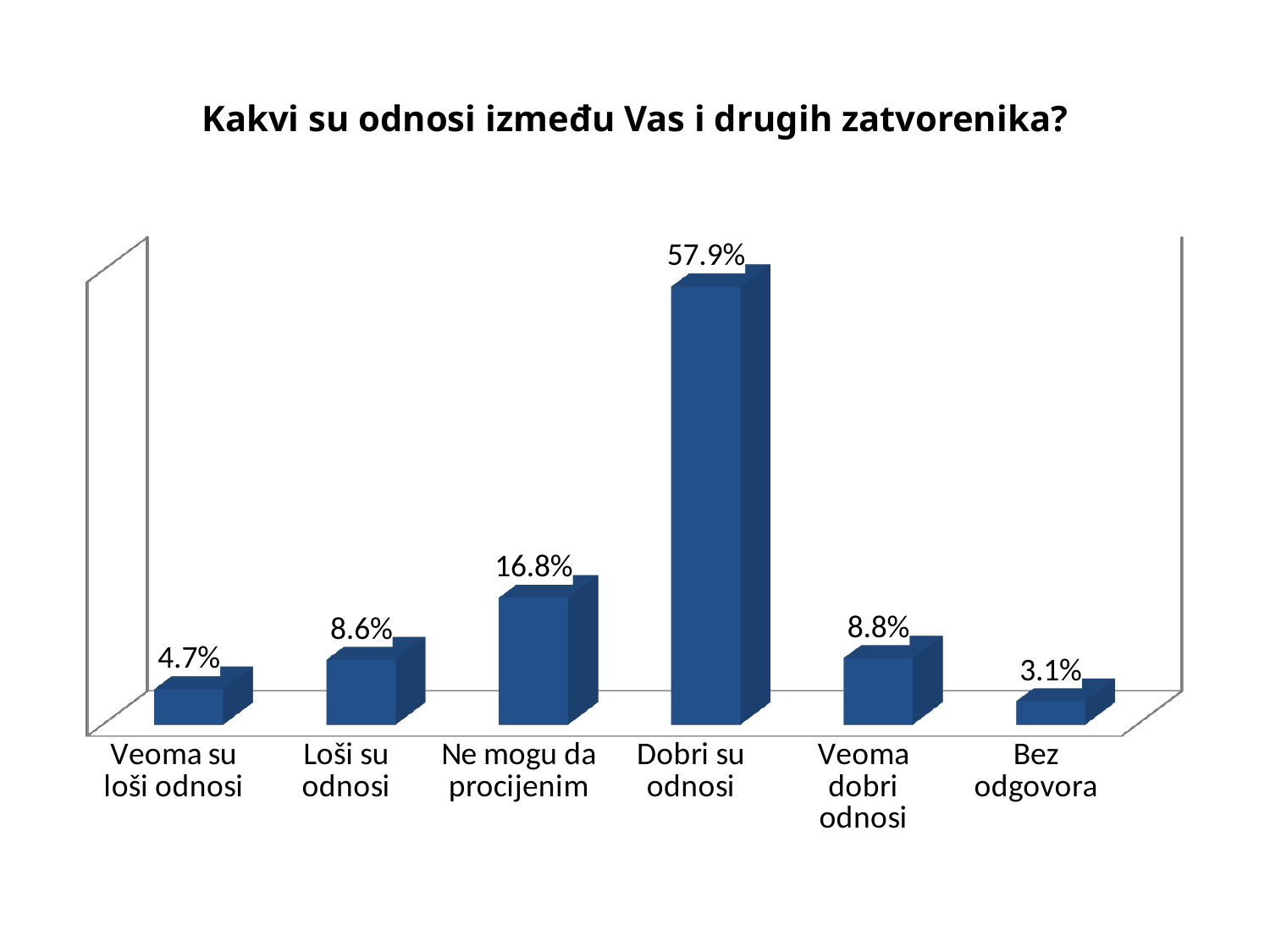
What is the value for "Bez odgovora"? 3.1% What is the difference between the values for "Dobri su odnosi" and "Ne mogu da procijenim"? 41.1% How many categories are shown in the chart? 6 What is the value for "Ne mogu da procijenim"? 16.8% What is the value for "Veoma su loši odnosi"? 4.7% Which is larger, the value for "Ne mogu da procijenim" or the value for "Veoma dobri odnosi"? Ne mogu da procijenim What is the value for "Dobri su odnosi"? 57.9% What is the title of the chart? Kakvi su odnosi između Vas i drugih zatvorenika? What kind of chart is shown on the slide? Bar chart Which category has the lowest value? Bez odgovora Which category has the highest value? Dobri su odnosi What is the difference between the values for "Veoma dobri odnosi" and "Loši su odnosi"? 0.2%